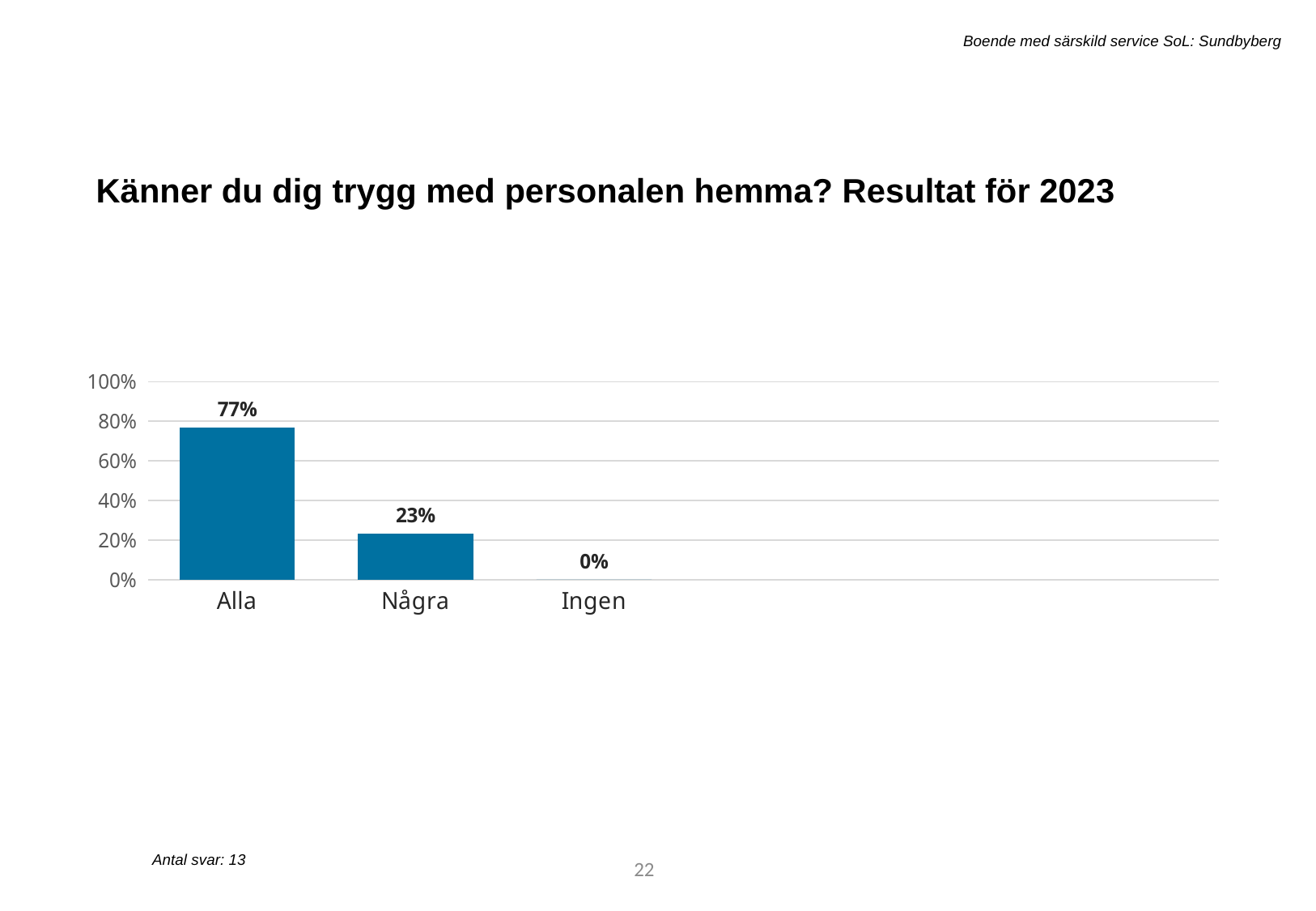
What is the difference between the values for Alla and Några? 54% Do the values rise or fall from left to right along the x axis? fall What is the value for Ingen? 0% Which is larger, the value for Alla or the value for Några? Alla What kind of chart is shown on the slide? bar chart Which category has the highest value? Alla Is the value for Några greater or less than 40%? less How many categories are shown on the x axis? 3 Which category has the lowest value? Ingen What is the value for Alla? 77% Is the value for Alla greater or less than 60%? greater What is the value for Några? 23%